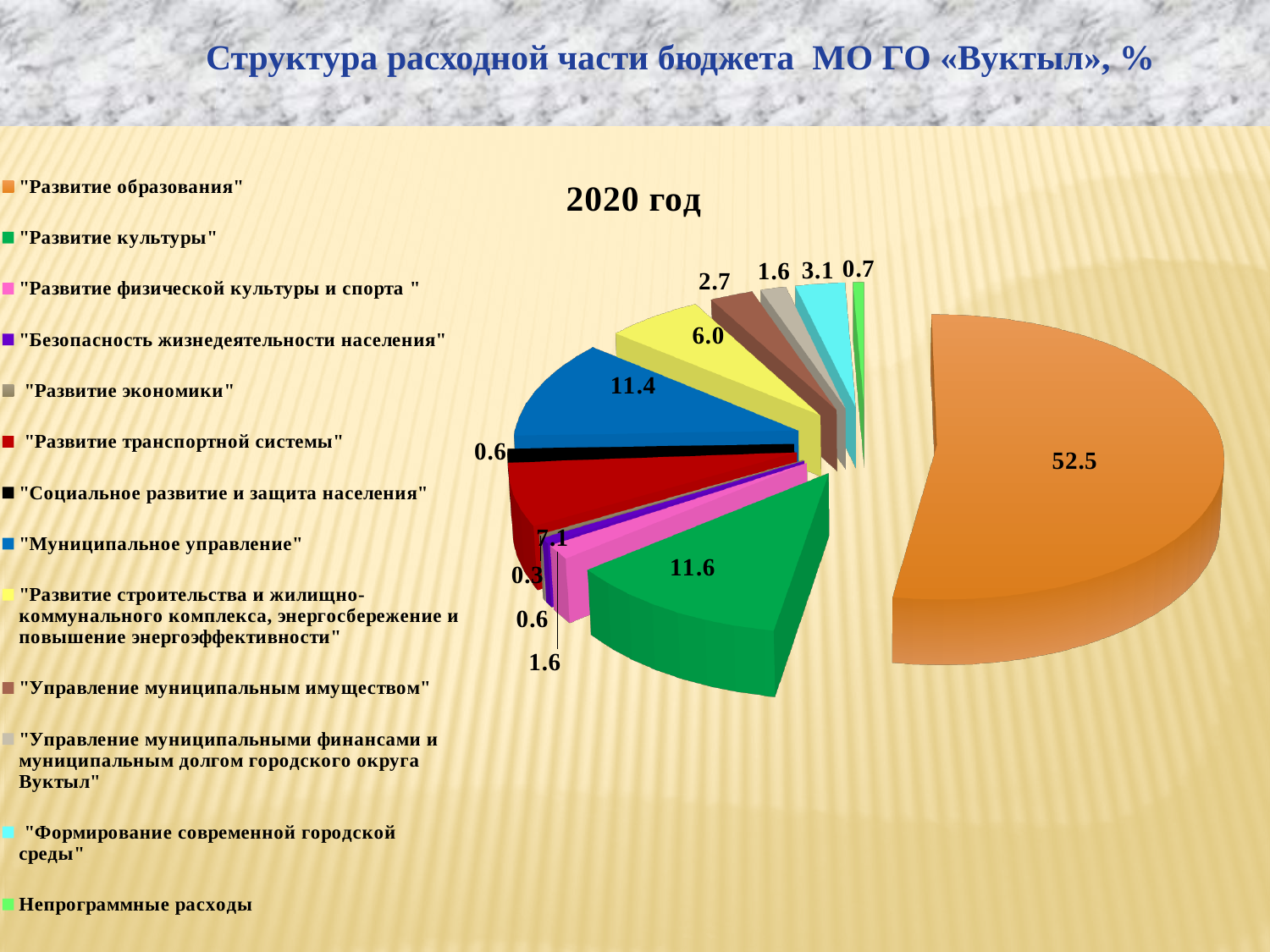
How many categories does the legend list? 13 What is the value for "Развитие строительства и жилищно-коммунального комплекса, энергосбережение и повышение энергоэффективности"? 6.0 What is the title shown above the pie chart? 2020 год What is the value for "Непрограммные расходы"? 0.7 Which category has the largest share of the budget expenditure? "Развитие образования" What type of chart is shown on the slide? pie chart What is the difference between the values for "Развитие образования" and "Развитие культуры"? 40.9 What is the value for "Муниципальное управление"? 11.4 What is the value for "Развитие культуры"? 11.6 What is the value for "Формирование современной городской среды"? 3.1 What share of the budget expenditure goes to "Развитие образования"? 52.5 What is the value for "Управление муниципальным имуществом"? 2.7